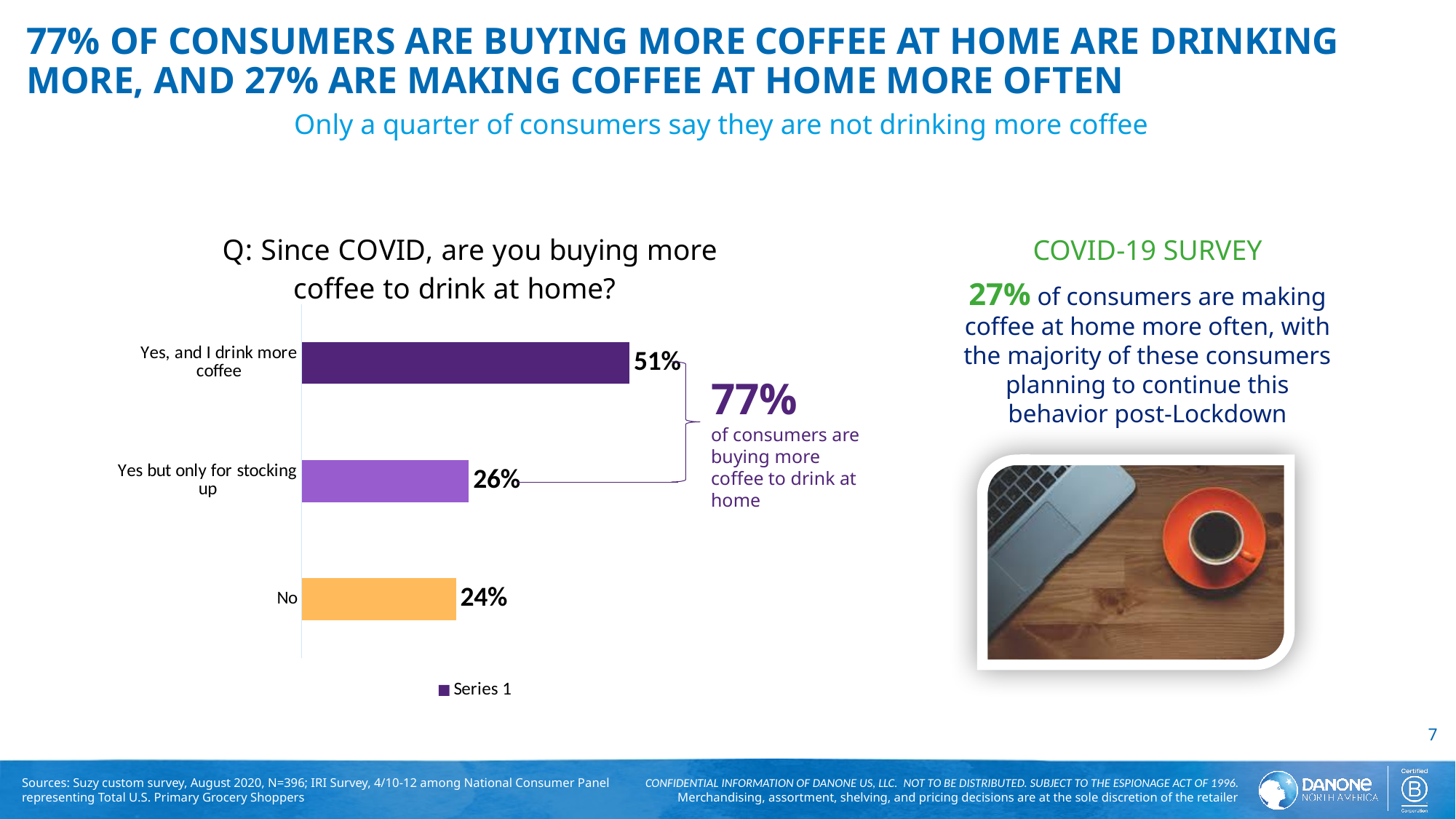
What percentage of consumers answered "Yes, and I drink more coffee"? 51% Which is larger: the value for "Yes but only for stocking up" or the value for "No"? Yes but only for stocking up What is the difference between the "Yes, and I drink more coffee" value and the "No" value? 27% How many series does the chart legend list? 1 What percentage of consumers answered "Yes but only for stocking up"? 26% Which response category has the highest value? Yes, and I drink more coffee What is the name of the series listed in the chart legend? Series 1 How many response categories are shown in the chart? 3 Which response category has the lowest value? No What percentage of consumers answered "No"? 24% What kind of chart is shown on the slide? Bar chart What is the combined value of the two "Yes" responses, as called out next to the chart? 77%